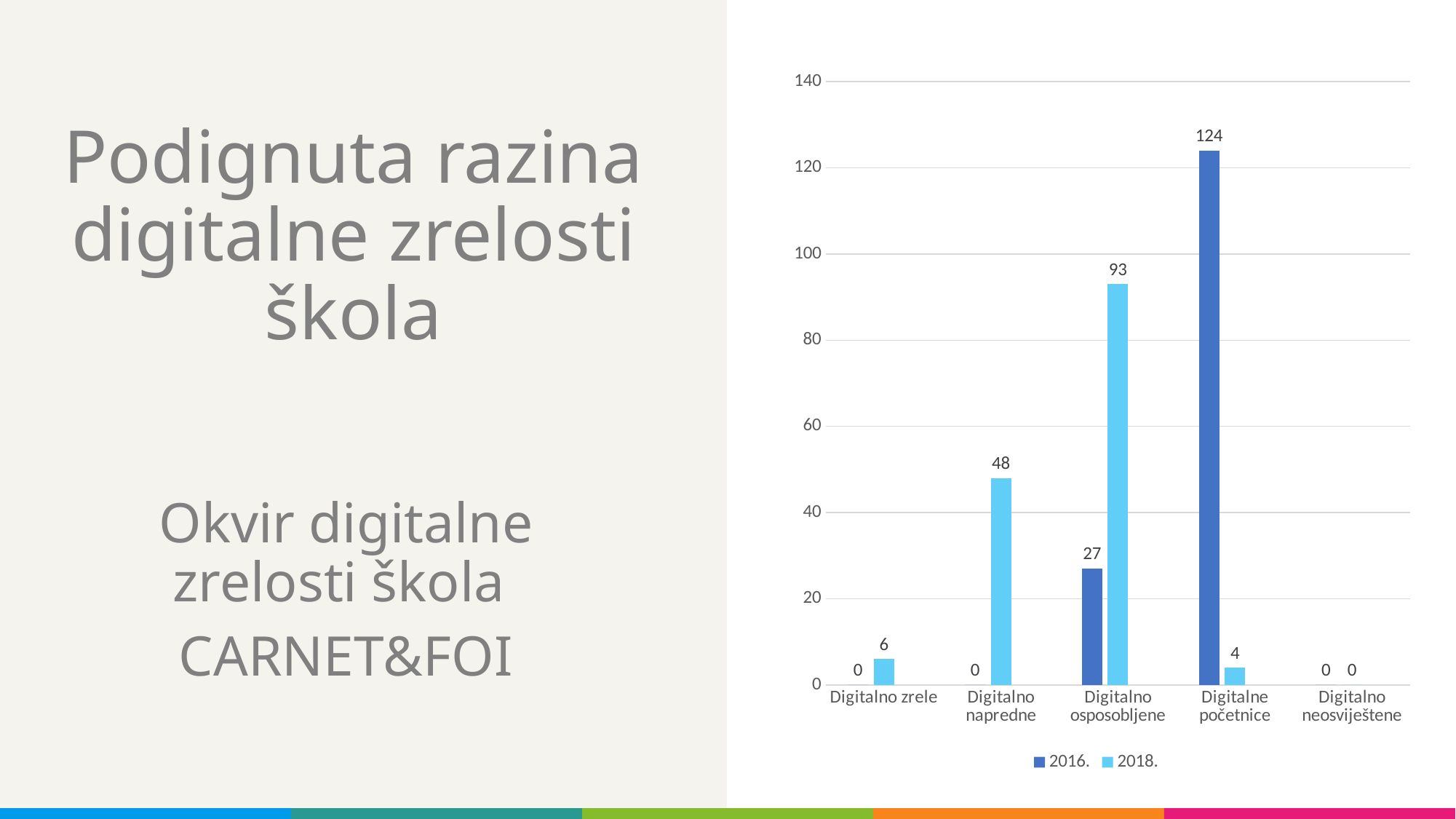
What kind of chart is shown on the slide? Bar chart What is the difference between the 2016. and 2018. values for Digitalne početnice? 120 What is the value for Digitalno osposobljene in 2018.? 93 What is the value for Digitalno zrele in 2018.? 6 What is the value for Digitalno napredne in 2018.? 48 What is the difference between the 2018. and 2016. values for Digitalno osposobljene? 66 Which category has the highest value in the 2016. series? Digitalne početnice How many categories are shown on the x axis? 5 Which is larger for Digitalno napredne: the 2016. value or the 2018. value? 2018. Which category has the highest value in the 2018. series? Digitalno osposobljene What is the value for Digitalne početnice in 2016.? 124 How many series does the legend list? 2